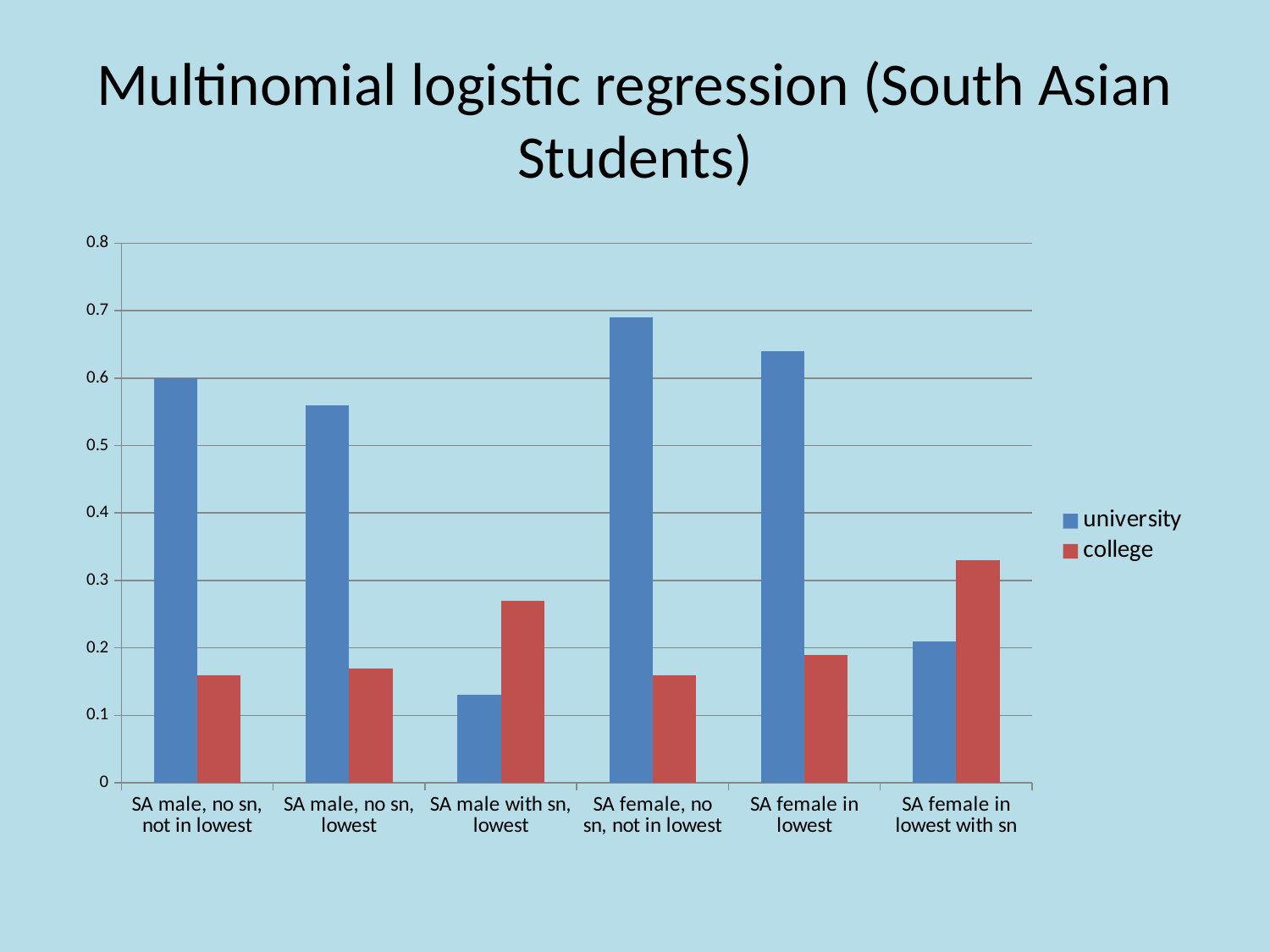
How many series does the legend list? 2 Which category has the highest university value? SA female, no sn, not in lowest For 'SA female in lowest', which is larger: the university value or the college value? university Which category has the lowest university value? SA male with sn, lowest What is the university value for 'SA male, no sn, not in lowest'? 0.6 For 'SA male with sn, lowest', which is larger: the university value or the college value? college Which category has the highest college value? SA female in lowest with sn Is the university value for 'SA female in lowest' greater or less than 0.6? greater How many categories are shown on the x axis? 6 Is the college value for 'SA male with sn, lowest' greater or less than 0.3? less What kind of chart is shown on the slide? bar chart What colour are the bars for the college series? red